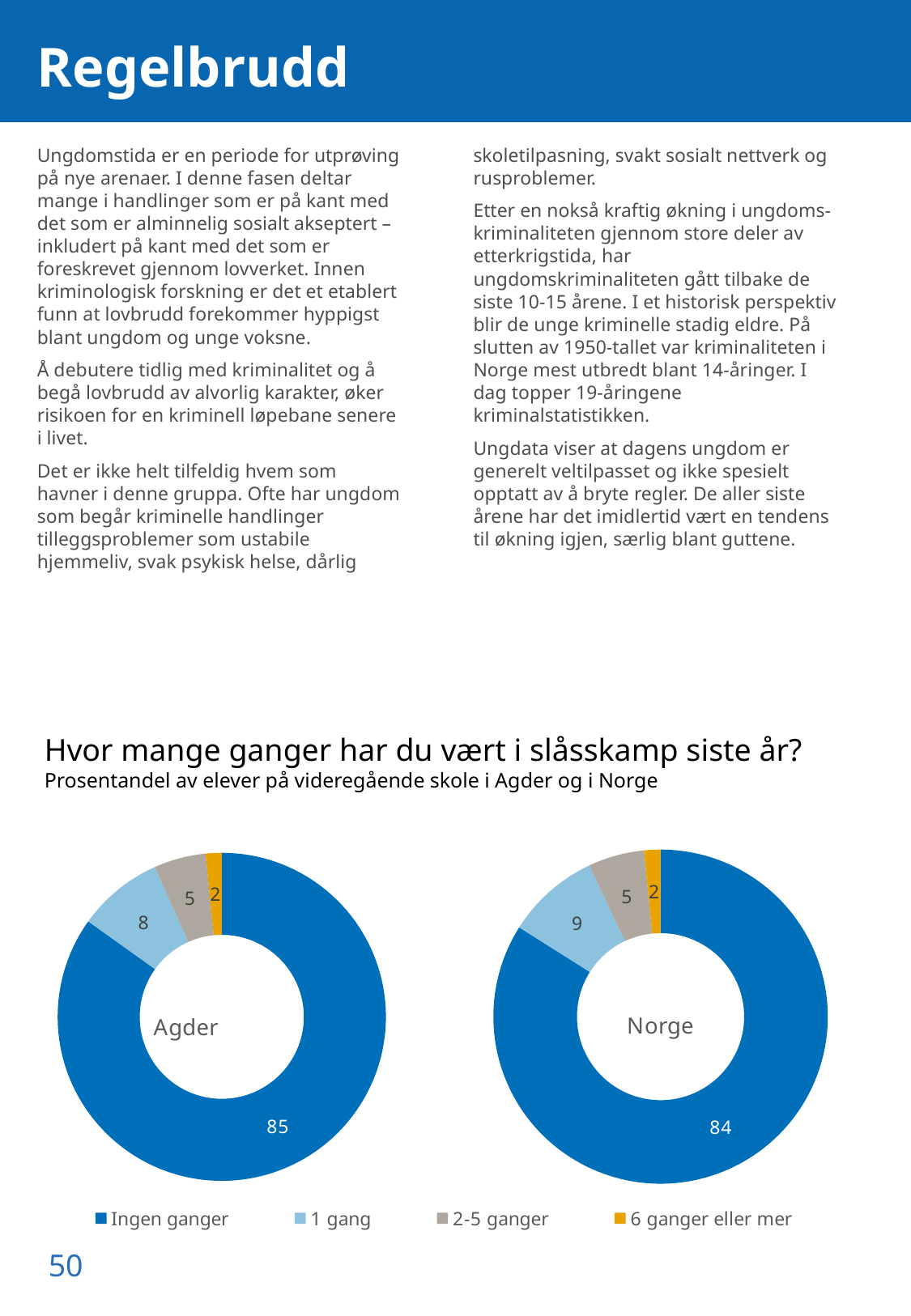
How many categories does each donut chart show? 4 In the Norge donut chart, what is the value for "1 gang"? 9 In the Agder donut chart, what is the value for "Ingen ganger"? 85 In the Norge donut chart, what is the value for "6 ganger eller mer"? 2 In the Agder donut chart, what is the value for "2-5 ganger"? 5 What is the title of the chart section on the slide? Hvor mange ganger har du vært i slåsskamp siste år? What is the difference between the "Ingen ganger" value in the Agder chart and the "Ingen ganger" value in the Norge chart? 1 How many entries does the legend below the charts list? 4 Which is larger: the "1 gang" value in the Agder chart or the "1 gang" value in the Norge chart? Norge What type of chart is used to show the Agder and Norge data? Donut (pie) chart In the Agder donut chart, which category has the largest share? Ingen ganger In the Norge donut chart, which category has the smallest share? 6 ganger eller mer